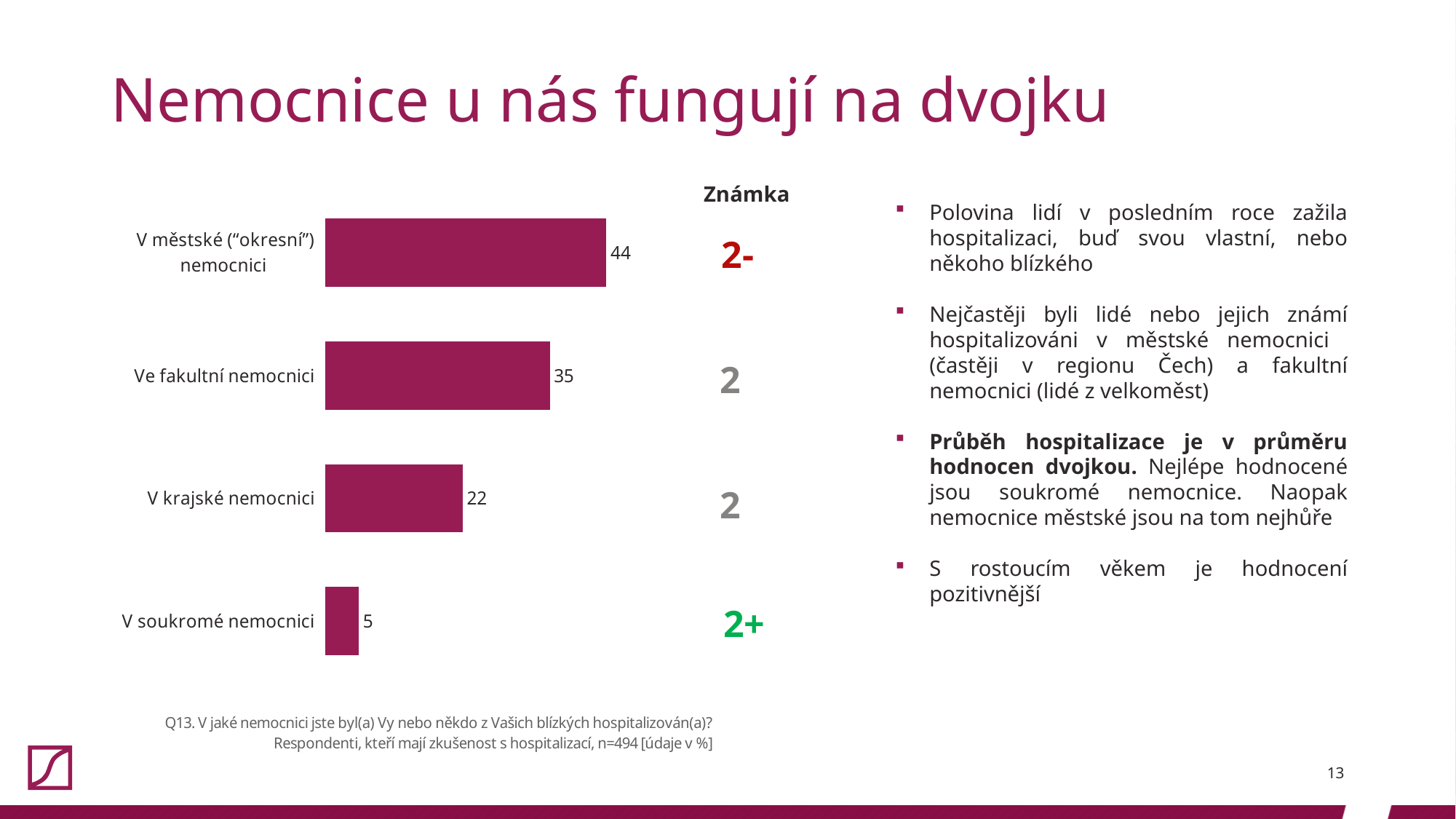
What is the value for "V soukromé nemocnici"? 5 Which category has the lowest value? V soukromé nemocnici What is the value for "V krajské nemocnici"? 22 Which is larger, the value for "Ve fakultní nemocnici" or "V krajské nemocnici"? Ve fakultní nemocnici Which category has the highest value? V městské ("okresní") nemocnici What kind of chart is shown on the slide? Bar chart What "Známka" (grade) is shown next to "V soukromé nemocnici"? 2+ What is the value for "V městské ("okresní") nemocnici"? 44 What is the difference between the values for "V městské ("okresní") nemocnici" and "Ve fakultní nemocnici"? 9 How many categories does the chart show? 4 What is the value for "Ve fakultní nemocnici"? 35 What is the difference between the values for "V krajské nemocnici" and "V soukromé nemocnici"? 17